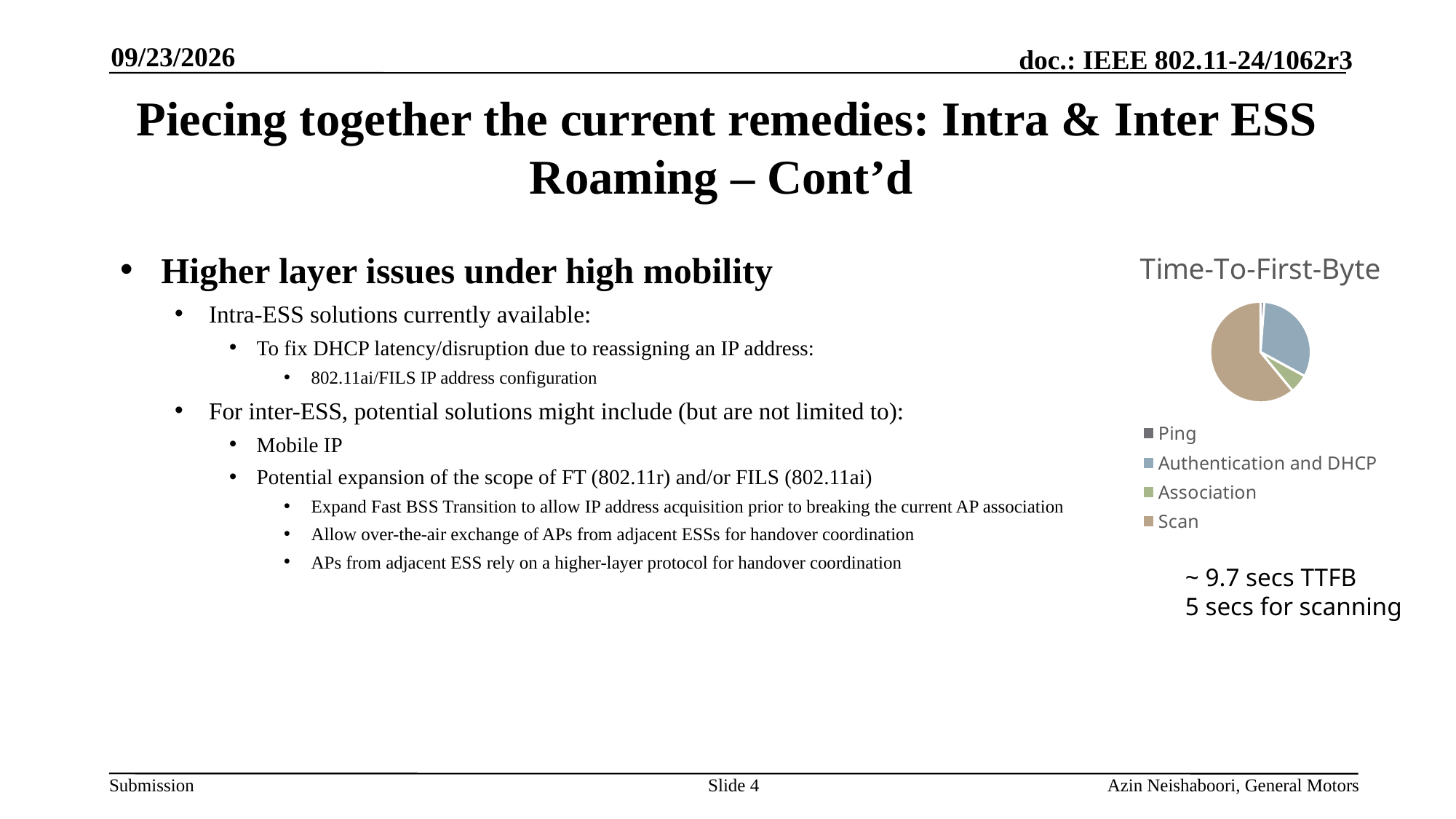
In the Time-To-First-Byte pie chart, which slice is larger: Scan or Authentication and DHCP? Scan What kind of chart is shown on the slide? Pie chart In the Time-To-First-Byte pie chart, which slice is larger: Authentication and DHCP or Association? Authentication and DHCP What is the title of the pie chart? Time-To-First-Byte In the Time-To-First-Byte pie chart, which slice is larger: Scan or Association? Scan Which category has the largest slice in the Time-To-First-Byte pie chart? Scan How many categories does the pie chart's legend list? 4 Which legend entry in the pie chart is shown in green? Association Which category has the smallest slice in the Time-To-First-Byte pie chart? Ping